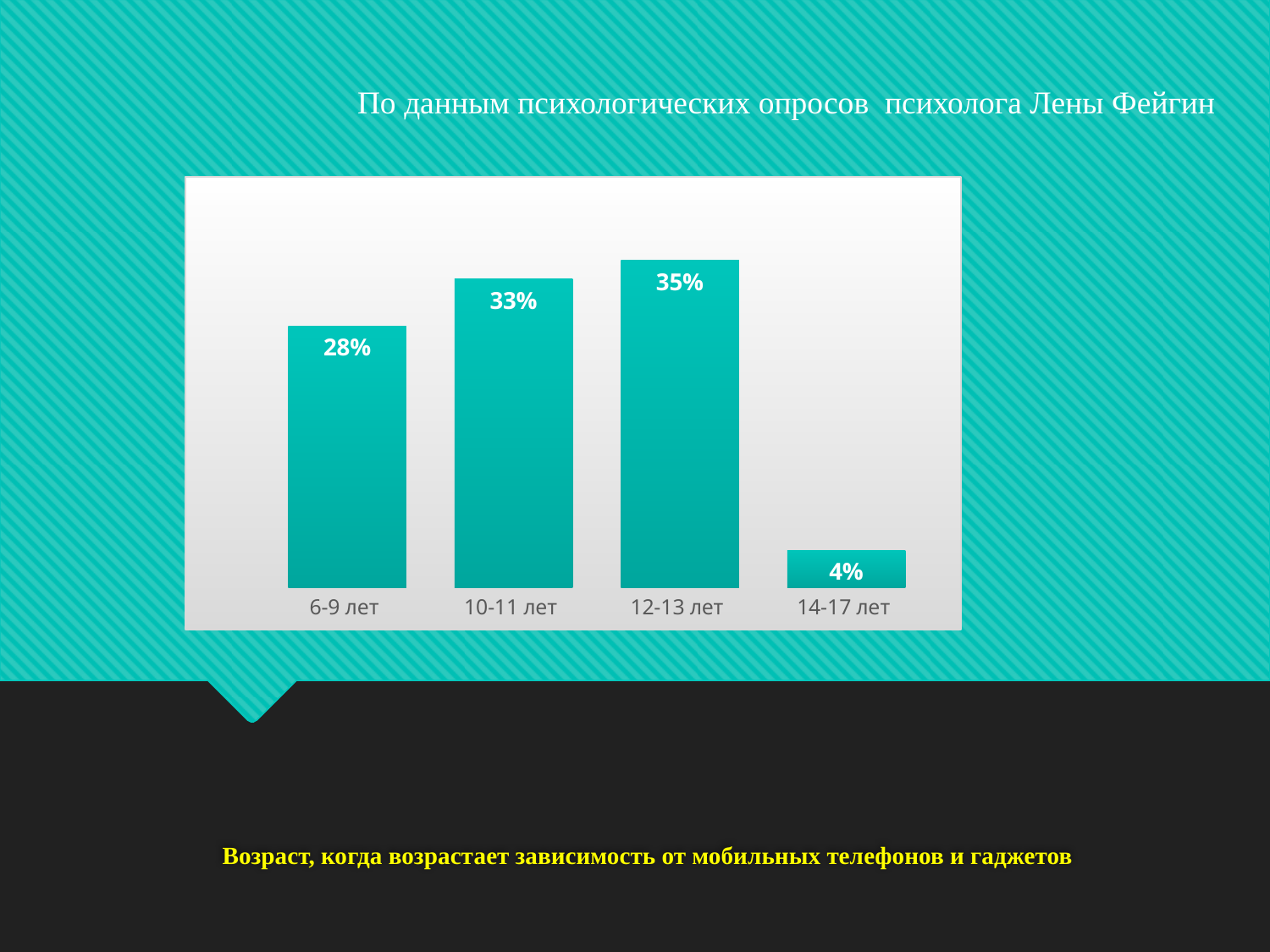
What is the value for the 10-11 лет category? 33% What is the difference between the values for 12-13 лет and 6-9 лет? 7% What colour are the bars in the chart? Teal How many age categories are shown in the chart? 4 What is the value for the 6-9 лет category? 28% What is the value for the 12-13 лет category? 35% Which is larger, the value for 10-11 лет or the value for 6-9 лет? 10-11 лет What kind of chart is shown on the slide? Bar chart What is the difference between the values for 10-11 лет and 14-17 лет? 29% Which age category has the lowest value? 14-17 лет What is the value for the 14-17 лет category? 4% Which age category has the highest value? 12-13 лет